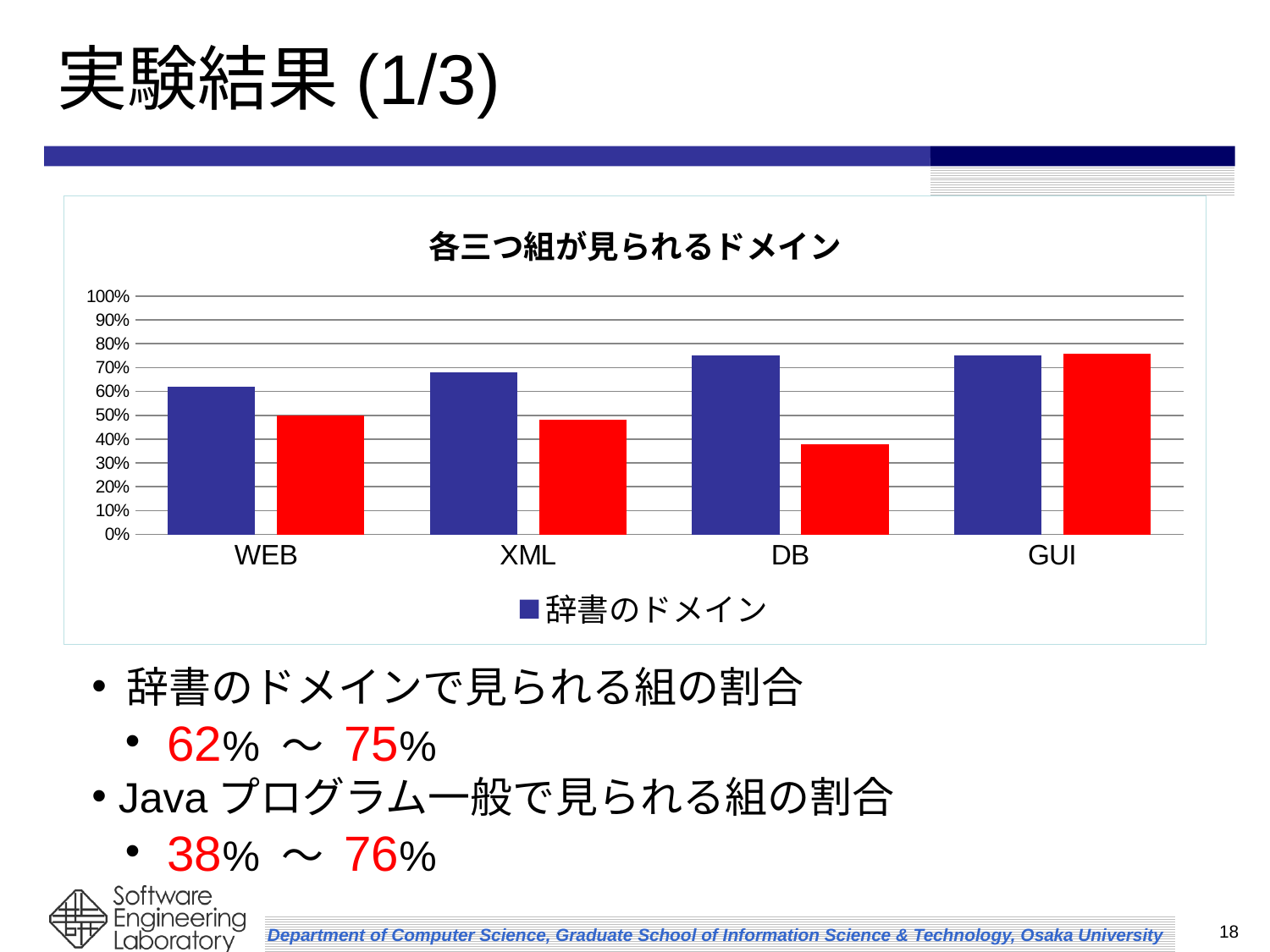
How many series does the chart's legend list? 1 Among the red bars, which category has the lowest value? DB For WEB, which bar is larger, the blue 辞書のドメイン bar or the red bar? the blue 辞書のドメイン bar How many categories are shown on the x axis of the chart? 4 Is the 辞書のドメイン value for WEB greater or less than 50%? greater Among the red bars, which category has the highest value? GUI Is the 辞書のドメイン value for DB greater or less than 70%? greater What colour are the bars for the 辞書のドメイン series? blue What kind of chart is shown on the slide? bar chart Is the red bar for GUI greater or less than 70%? greater What is the title of the chart? 各三つ組が見られるドメイン